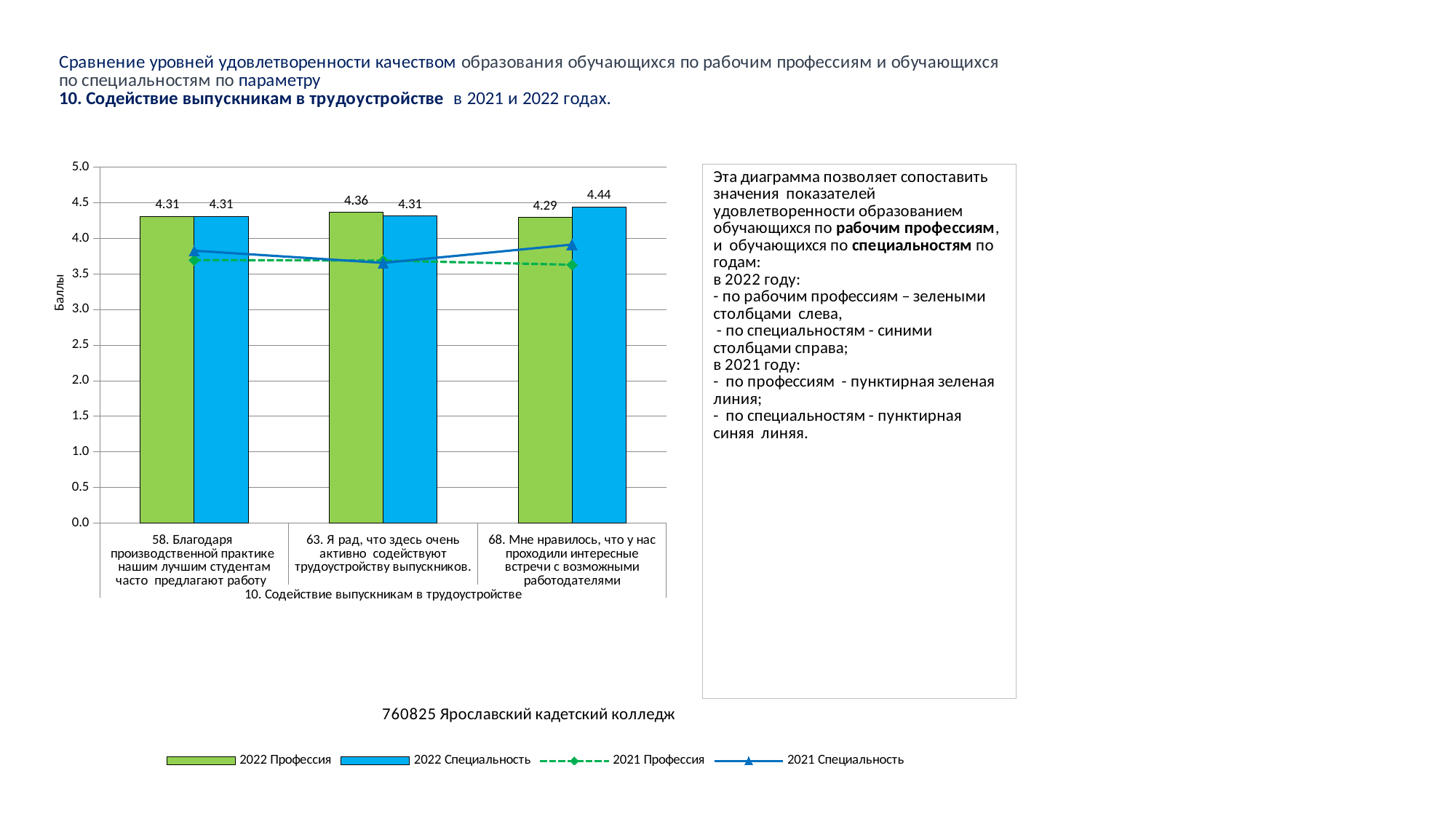
What is the label of the y axis? Баллы Is the 2021 Специальность line value for category 68 greater or less than 4.0? less Which category has the highest 2022 Специальность bar? 68. Мне нравилось, что у нас проходили интересные встречи с возможными работодателями What is the value of the 2022 Специальность bar for category 68 (Мне нравилось, что у нас проходили интересные встречи с возможными работодателями)? 4.44 Which category has the lowest 2022 Профессия bar? 68. Мне нравилось, что у нас проходили интересные встречи с возможными работодателями What kind of chart is shown on the slide? Combined bar and line chart How many series does the legend list? 4 How many categories are shown on the x axis? 3 What is the difference between the 2022 Специальность and 2022 Профессия values for category 68? 0.15 What is the value of the 2022 Профессия bar for category 58 (Благодаря производственной практике нашим лучшим студентам часто предлагают работу)? 4.31 What is the value of the 2022 Профессия bar for category 63 (Я рад, что здесь очень активно содействуют трудоустройству выпускников)? 4.36 For category 63, which is larger: the 2022 Профессия bar or the 2022 Специальность bar? 2022 Профессия